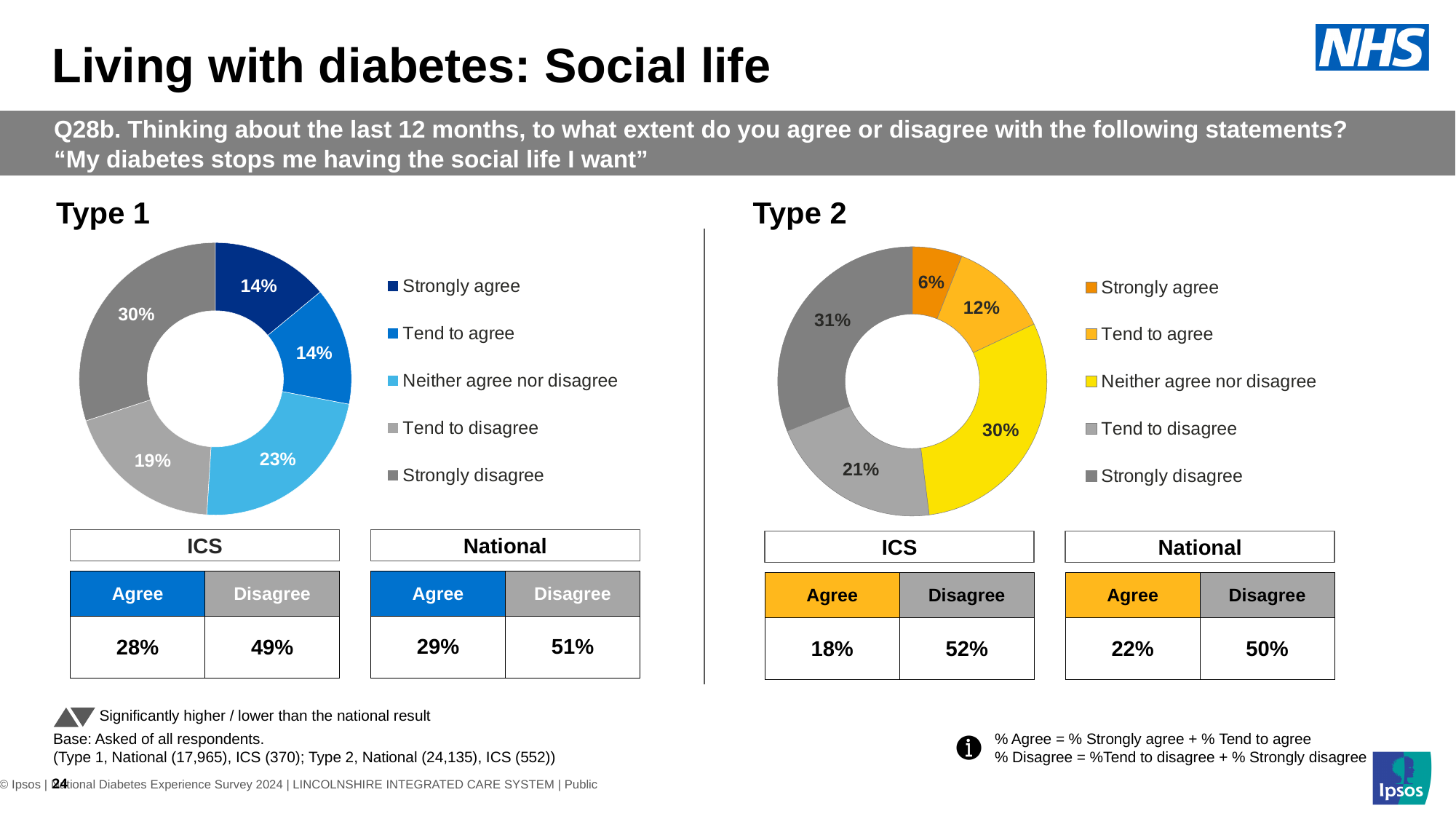
How many response categories does the Type 1 chart's legend list? 5 In the Type 2 chart, what is the difference between the Neither agree nor disagree share and the Tend to agree share? 18 percentage points In the Type 2 chart, what percentage of respondents said they tend to disagree? 21% In the Type 1 chart, what is the difference between the Strongly disagree share and the Tend to disagree share? 11 percentage points What type of chart is used for the Type 2 data? Donut chart In the Type 2 chart, what percentage of respondents said they strongly agree? 6% In the Type 1 chart, what percentage of respondents said they neither agree nor disagree? 23% In the Type 1 chart, what percentage of respondents said they strongly agree? 14% In the Type 2 chart, which is larger: the Tend to agree share or the Tend to disagree share? Tend to disagree In the Type 2 chart, which response category has the smallest share? Strongly agree In the Type 2 chart, what colour represents Neither agree nor disagree? Yellow In the Type 1 chart, which response category has the largest share? Strongly disagree